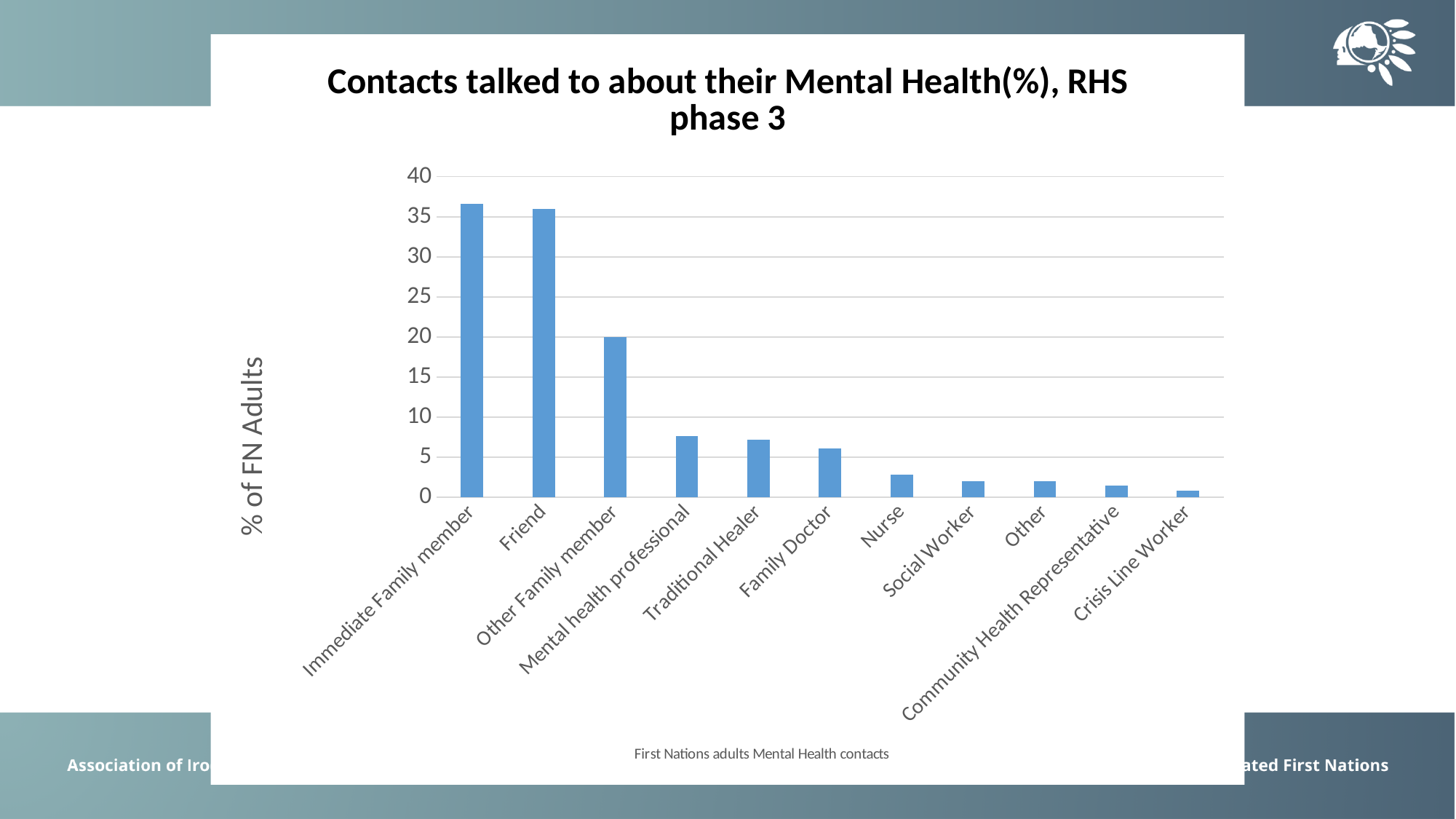
Do the values generally rise or fall moving from left to right along the x axis? Fall What kind of chart is shown on the slide? Bar chart Is the value for Friend greater or less than 30? greater Is the value for Traditional Healer greater or less than 10? less Is the value for Immediate Family member greater or less than 35? greater Which is larger, the value for Family Doctor or the value for Social Worker? Family Doctor How many categories are shown on the x axis of the chart? 11 Which category has the lowest value in the chart? Crisis Line Worker Which is larger, the value for Friend or the value for Other Family member? Friend What is the title of the vertical axis? % of FN Adults